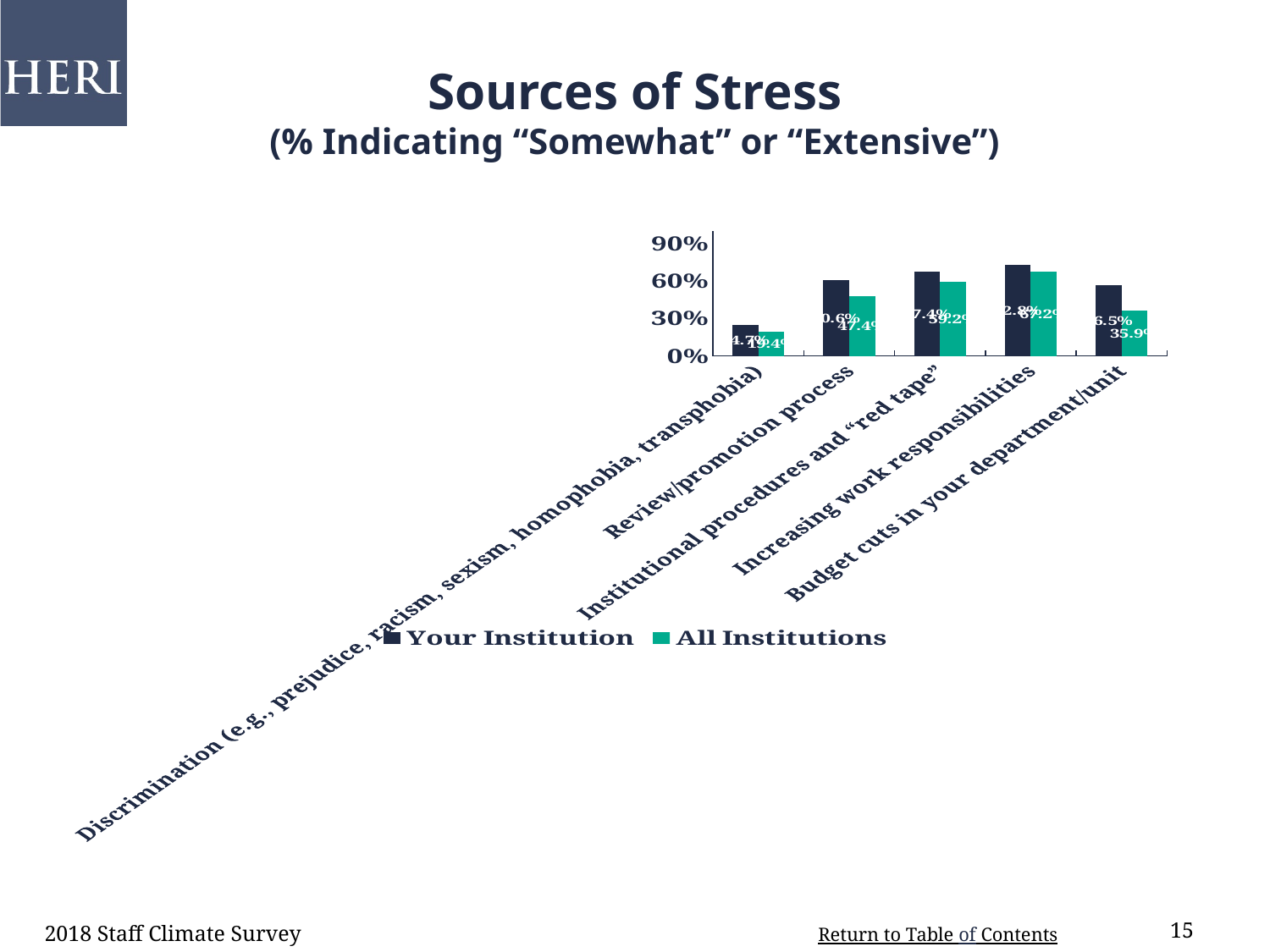
Which source of stress has the lowest value for Your Institution? Discrimination (e.g., prejudice, racism, sexism, homophobia, transphobia) For Review/promotion process, which is larger: Your Institution or All Institutions? Your Institution What is the All Institutions value for Budget cuts in your department/unit? 35.9% What type of chart is shown on the slide? Bar chart Is the Your Institution value for Discrimination greater or less than 30%? less What is the All Institutions value for Review/promotion process? 47.4% Which colour represents the All Institutions series in the legend? Teal (green) For Budget cuts in your department/unit, which is larger: Your Institution or All Institutions? Your Institution Which source of stress has the highest value for Your Institution? Increasing work responsibilities How many sources of stress (categories) are plotted on the chart? 5 How many series does the legend list? 2 Is the Your Institution value for Increasing work responsibilities greater or less than 60%? greater